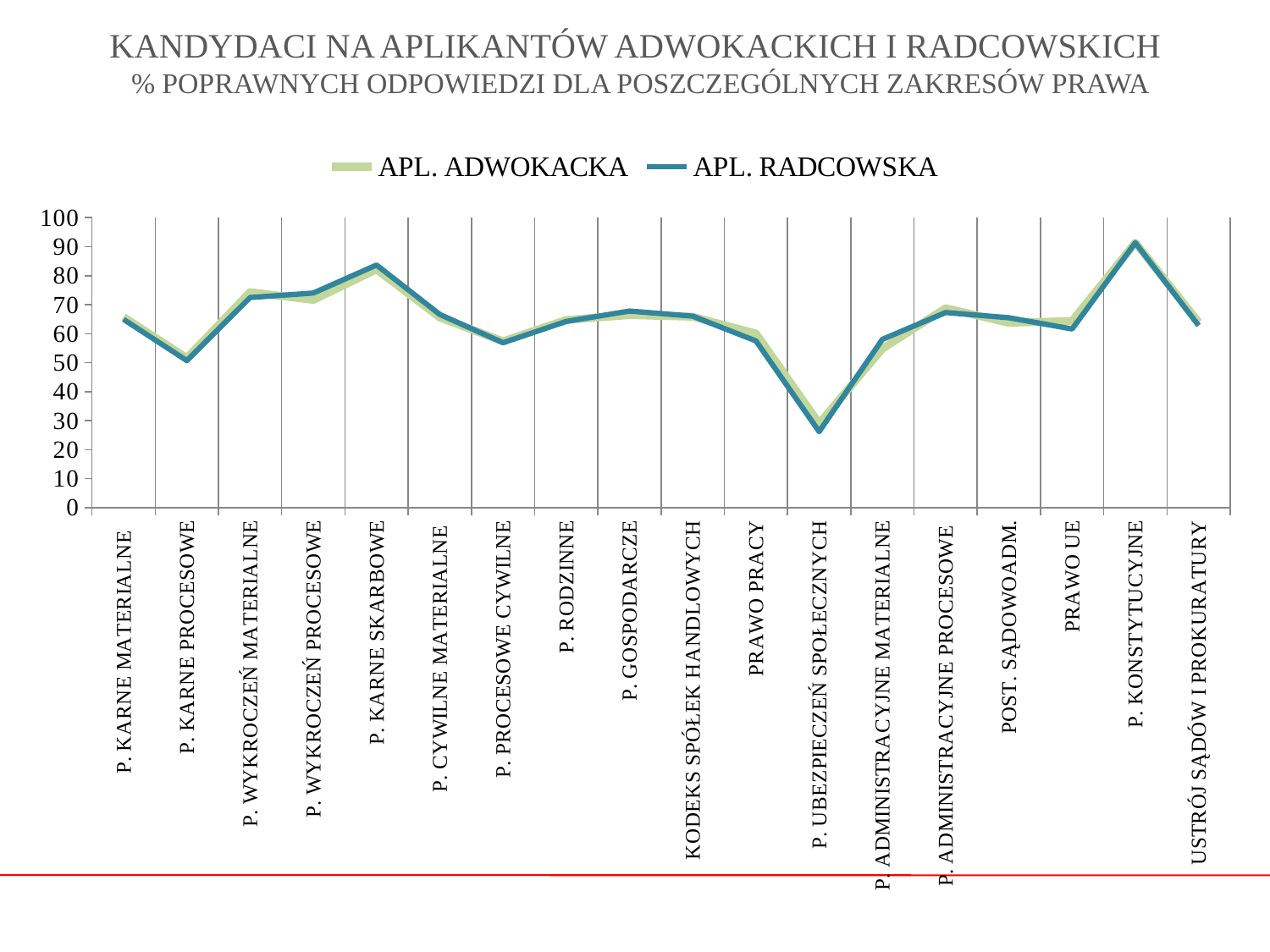
What kind of chart is shown on the slide? line chart Do the APL. RADCOWSKA values rise or fall from P. KARNE PROCESOWE to P. KARNE SKARBOWE? rise How many series does the legend list? 2 Which category has the lowest value for APL. ADWOKACKA? P. UBEZPIECZEŃ SPOŁECZNYCH Which category has the highest value for APL. RADCOWSKA? P. KONSTYTUCYJNE Which is larger for APL. RADCOWSKA: P. KARNE SKARBOWE or P. CYWILNE MATERIALNE? P. KARNE SKARBOWE Is the APL. RADCOWSKA value for P. KARNE SKARBOWE greater or less than 80? greater Is the APL. RADCOWSKA value for PRAWO PRACY greater or less than 70? less Is the APL. ADWOKACKA value for P. UBEZPIECZEŃ SPOŁECZNYCH greater or less than 40? less How many categories are plotted along the x axis? 18 Which is larger for APL. ADWOKACKA: P. KONSTYTUCYJNE or PRAWO UE? P. KONSTYTUCYJNE Which series is drawn with the light green line? APL. ADWOKACKA